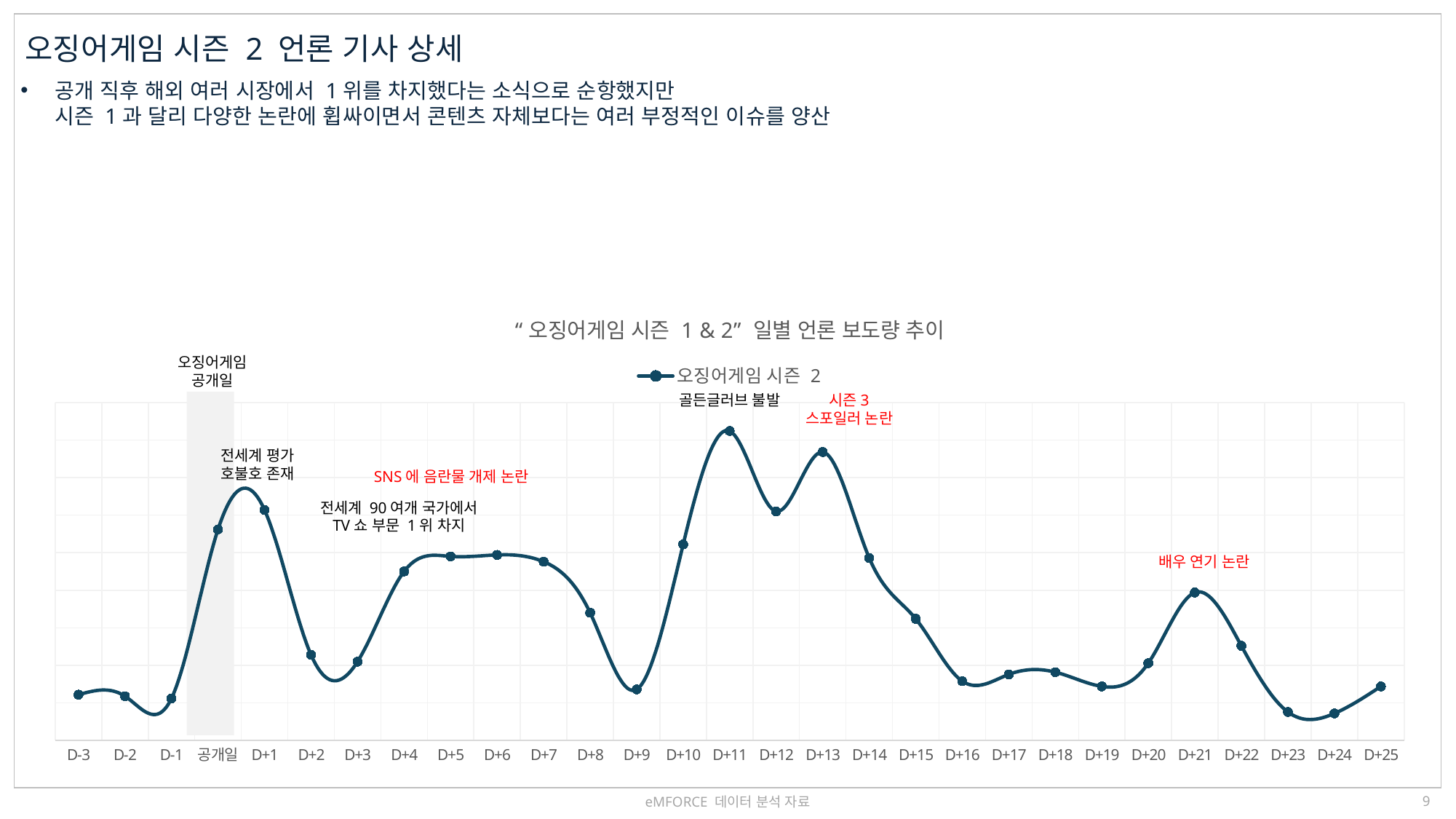
Which has the higher value, D+21 or D+16? D+21 Which has the higher value, 공개일 or D-1? 공개일 Do the values rise or fall from D+13 to D+16? Fall What kind of chart is shown on the slide? Line chart Which has the higher value, D+11 or D+13? D+11 How many series does the chart legend list? 1 Do the values rise or fall from D+3 to D+5? Rise What is the title of the chart? "오징어게임 시즌 1 & 2" 일별 언론 보도량 추이 On which day does the line reach its highest value? D+11 How many points are plotted along the x axis? 29 What is the name of the series shown in the legend? 오징어게임 시즌 2